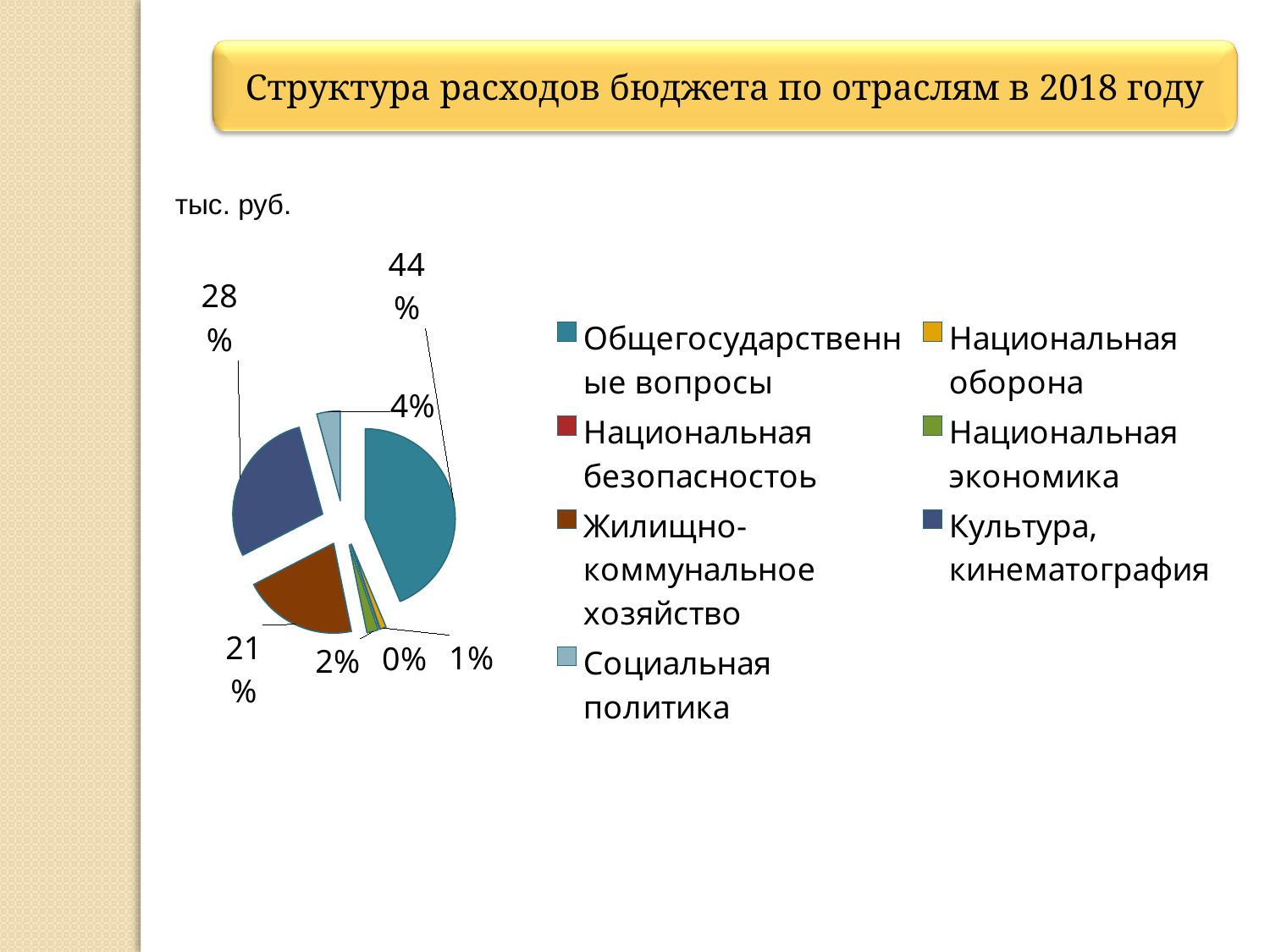
What share of the pie is Социальная политика? 4% What share of the pie is Культура, кинематография? 28% What is the title of the chart? Структура расходов бюджета по отраслям в 2018 году What kind of chart is shown on the slide? pie chart Which category has the largest slice of the pie? Общегосударственные вопросы What share of the pie is Жилищно-коммунальное хозяйство? 21% Which is larger: the slice for Культура, кинематография or the slice for Жилищно-коммунальное хозяйство? Культура, кинематография How many categories does the legend list? 7 What unit label is printed above the chart? тыс. руб. What is the difference in percentage points between the Общегосударственные вопросы slice and the Культура, кинематография slice? 16 What is the difference in percentage points between the Культура, кинематография slice and the Социальная политика slice? 24